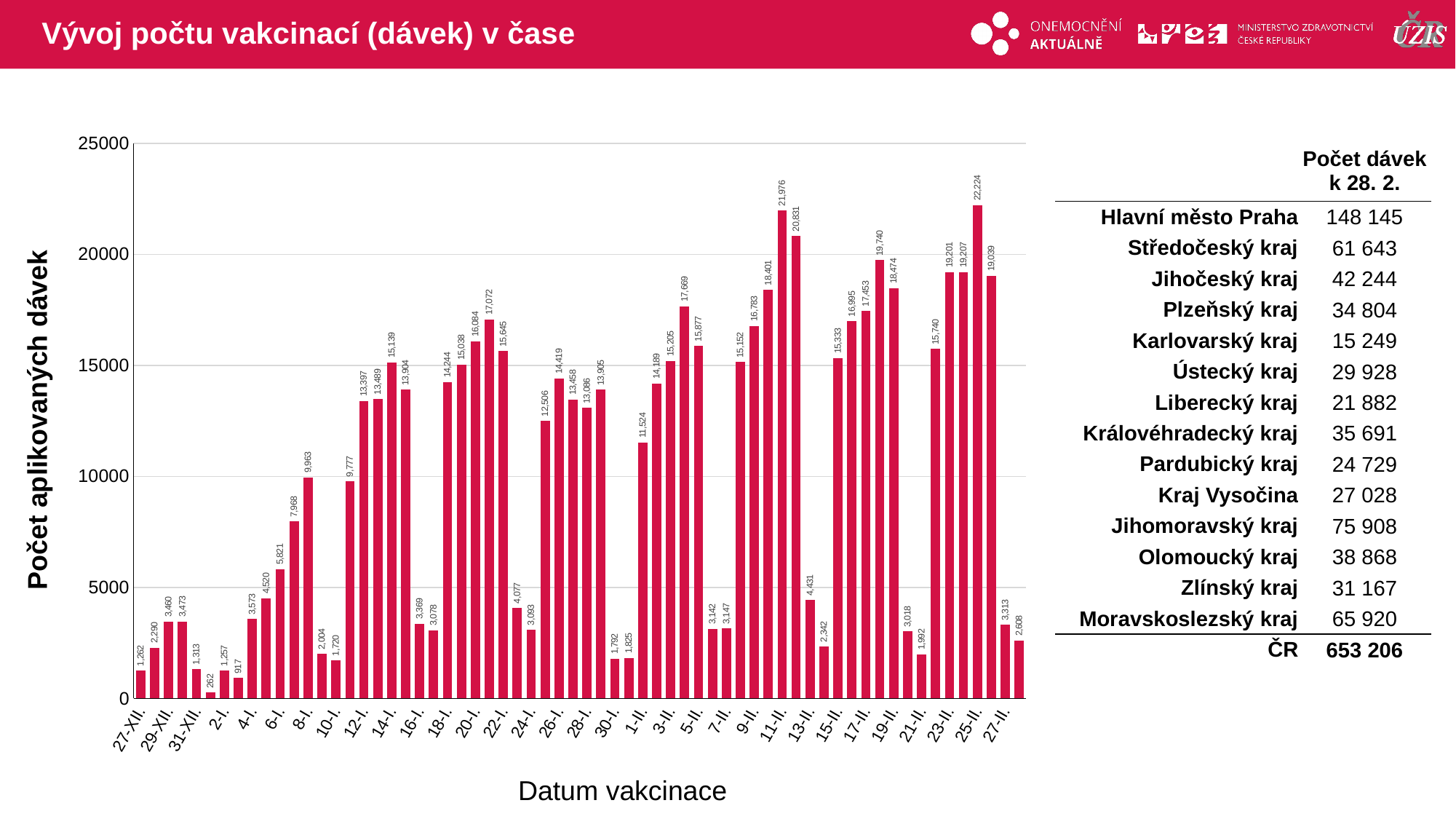
Which date has the larger value, 8-I or 12-I? 12-I What is the title of the vertical axis? Počet aplikovaných dávek What type of chart is shown on the slide? bar chart Do the weekday peaks generally rise or fall from the start of the period to the end? rise What is the value of the bar for 11-II? 21,976 What is the highest daily value shown in the chart? 22,224 Is the value for 20-I greater or less than 15000? greater What is the lowest daily value shown in the chart? 262 What is the title of the horizontal axis? Datum vakcinace What is the value of the bar for 1-II? 11,524 What is the difference between the highest bar (22,224) and the bar for 11-II (21,976)? 248 How many doses were applied on 8-I according to the chart? 9,963